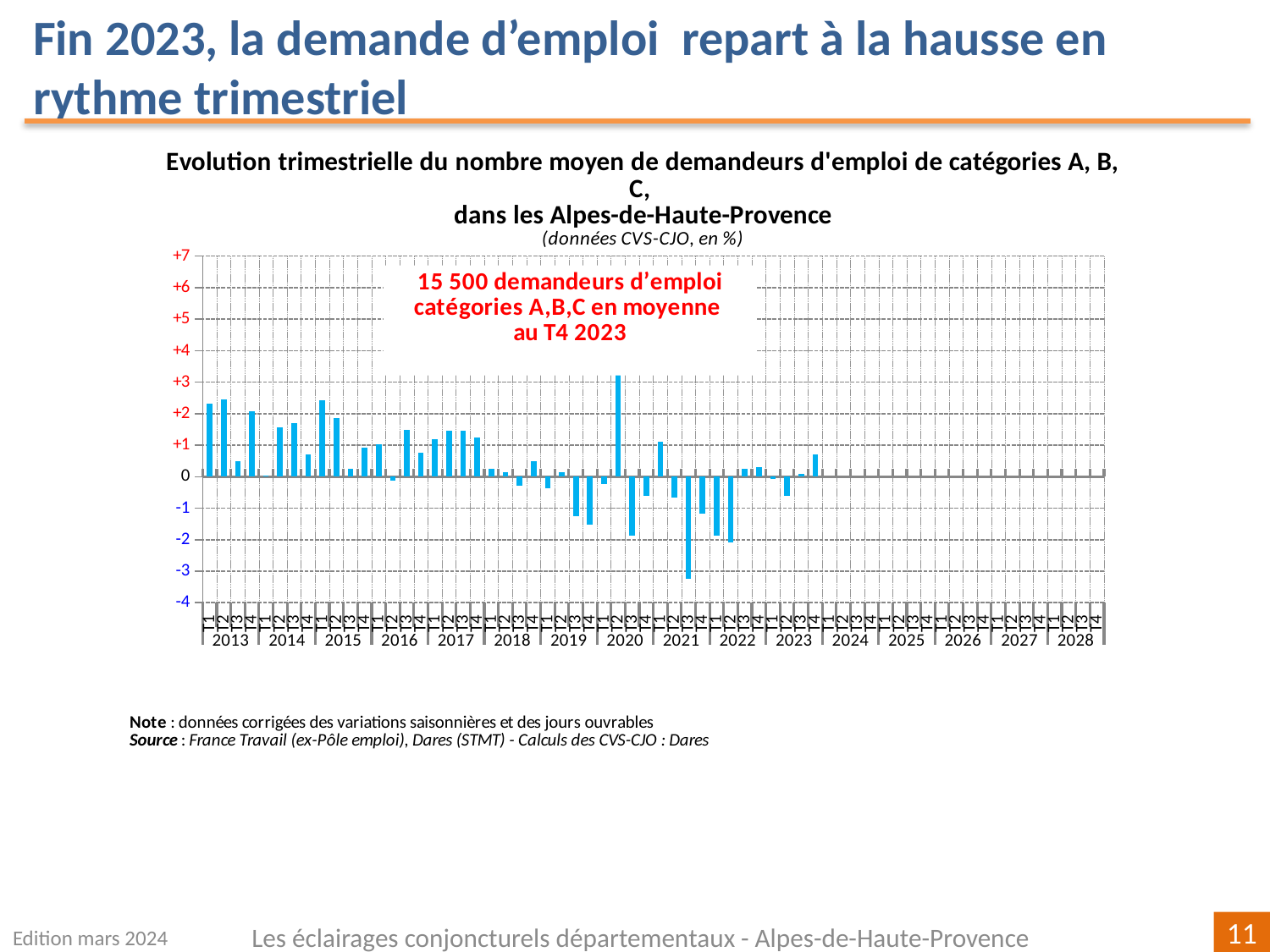
Which is lower, the value for T3 2021 or the value for T2 2022? T3 2021 Which quarter has the highest value in the chart? T2 2020 Is the value for T3 2021 greater or less than -2? less Which is larger, the value for T2 2020 or the value for T1 2013? T2 2020 What kind of chart is shown on the slide? bar chart How many years are labelled along the x axis of the chart? 16 Which quarter has the lowest value in the chart? T3 2021 According to the annotation in the chart, how many demandeurs d'emploi catégories A,B,C were there on average in T4 2023? 15 500 In what unit are the data in the chart expressed, according to the subtitle? % Is the value for T2 2020 greater or less than +2? greater Is the value for T4 2019 greater or less than -1? less